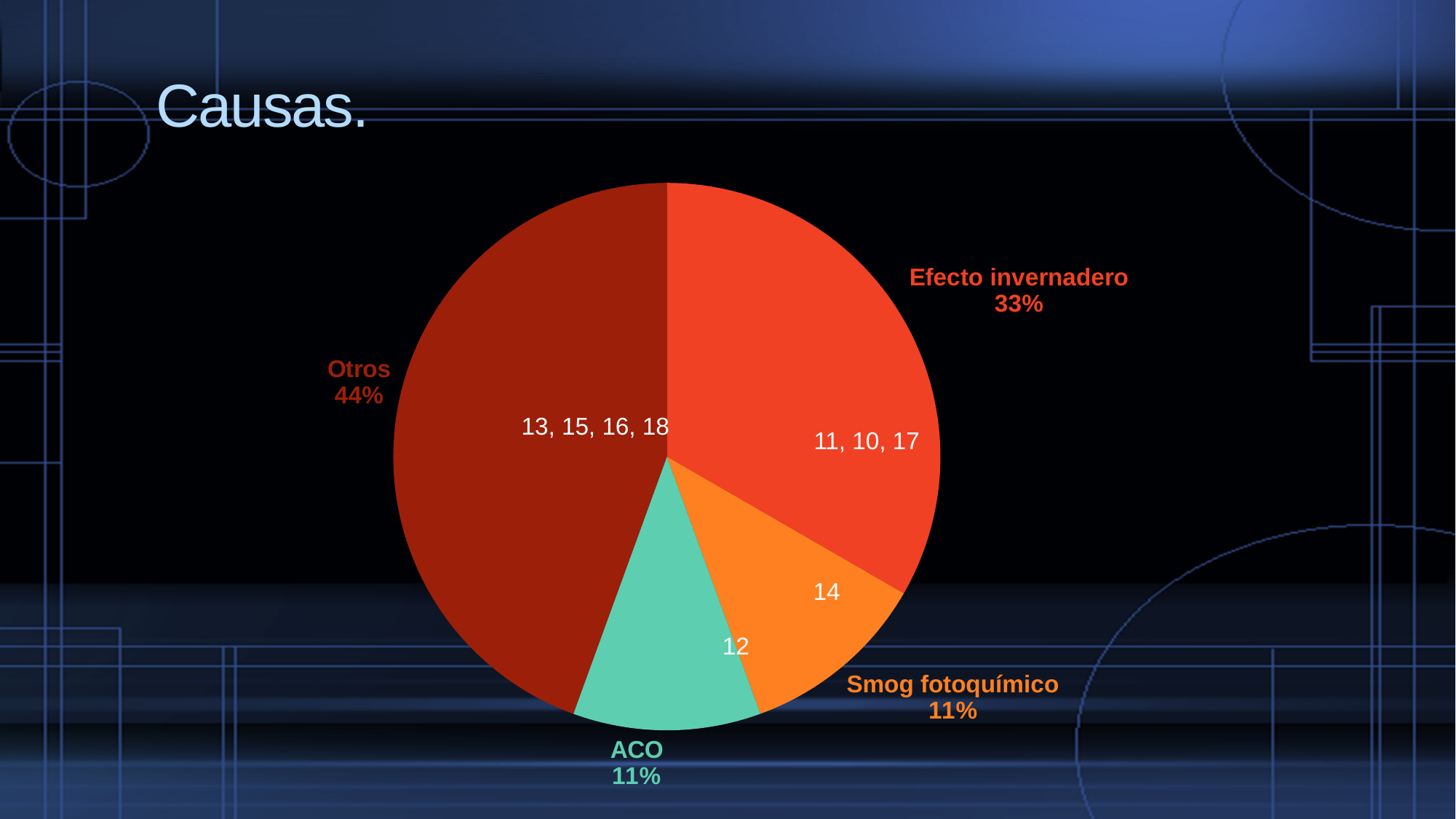
What is the difference in percentage points between the Otros slice and the Efecto invernadero slice? 11 What share of the pie does Efecto invernadero represent? 33% What share of the pie does Smog fotoquímico represent? 11% Which slice of the pie chart is the largest? Otros What is the title of the slide containing the pie chart? Causas. What share of the pie does ACO represent? 11% What is the difference in percentage points between the Efecto invernadero slice and the ACO slice? 22 How many slices does the pie chart have? 4 What colour is the ACO slice of the pie chart? teal (green) Which is larger, the Otros slice or the Efecto invernadero slice? Otros What kind of chart is shown on the slide? pie chart